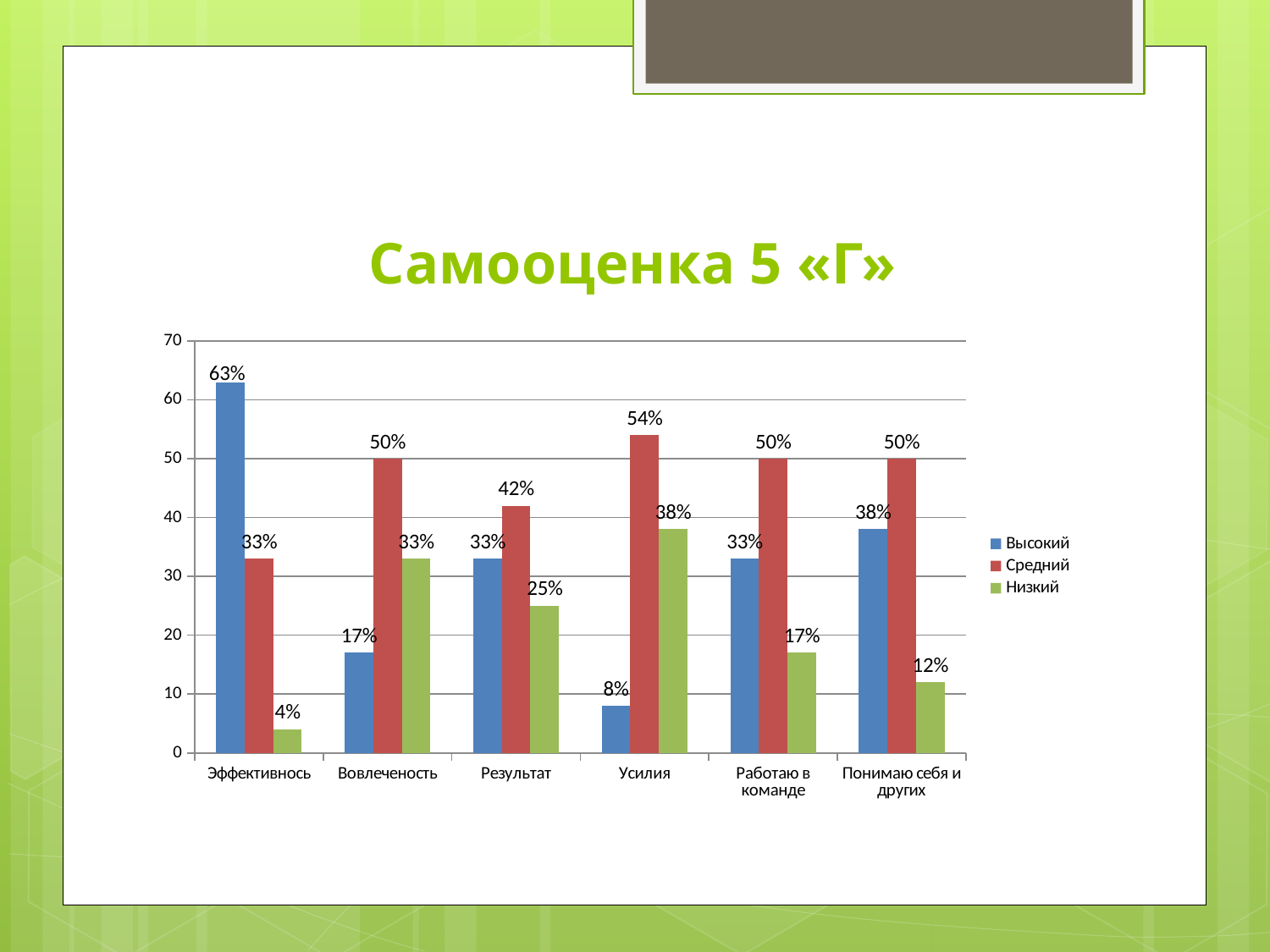
What kind of chart is shown on the slide? bar chart Which category has the highest Высокий value? Эффективнось What is the value of Высокий for Эффективнось? 63% What is the difference between the Средний and Высокий values for Усилия? 46% Which category has the lowest Низкий value? Эффективнось Is the Высокий value for Понимаю себя и других greater or less than 30? greater What is the value of Средний for Результат? 42% How many series does the legend list? 3 Which is larger for Вовлеченость: Высокий or Низкий? Низкий What is the title of the slide? Самооценка 5 «Г» What is the value of Низкий for Усилия? 38% How many categories are shown on the x axis? 6